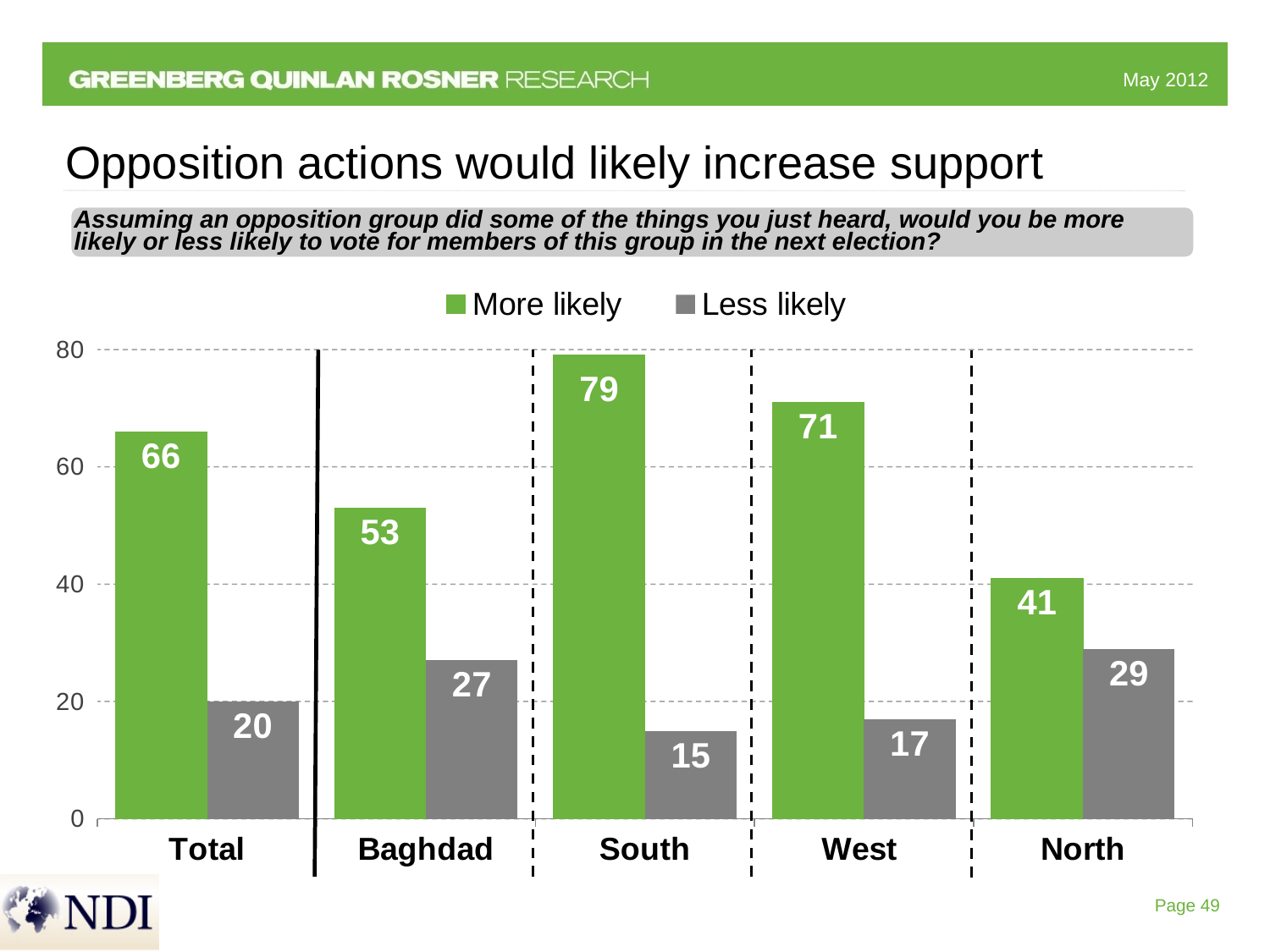
Is the 'Less likely' value for North greater or less than 20? greater What is the 'More likely' value for South? 79 What colour are the 'Less likely' bars? grey How many series does the legend list? 2 Which category has the lowest 'Less likely' value? South Which is larger, the 'More likely' value for Baghdad or the 'More likely' value for North? Baghdad What is the 'Less likely' value for Baghdad? 27 What kind of chart is shown on the slide? bar chart How many categories are shown on the x axis? 5 What is the difference between the 'More likely' and 'Less likely' values for West? 54 Which category has the highest 'More likely' value? South What is the 'More likely' value for Total? 66